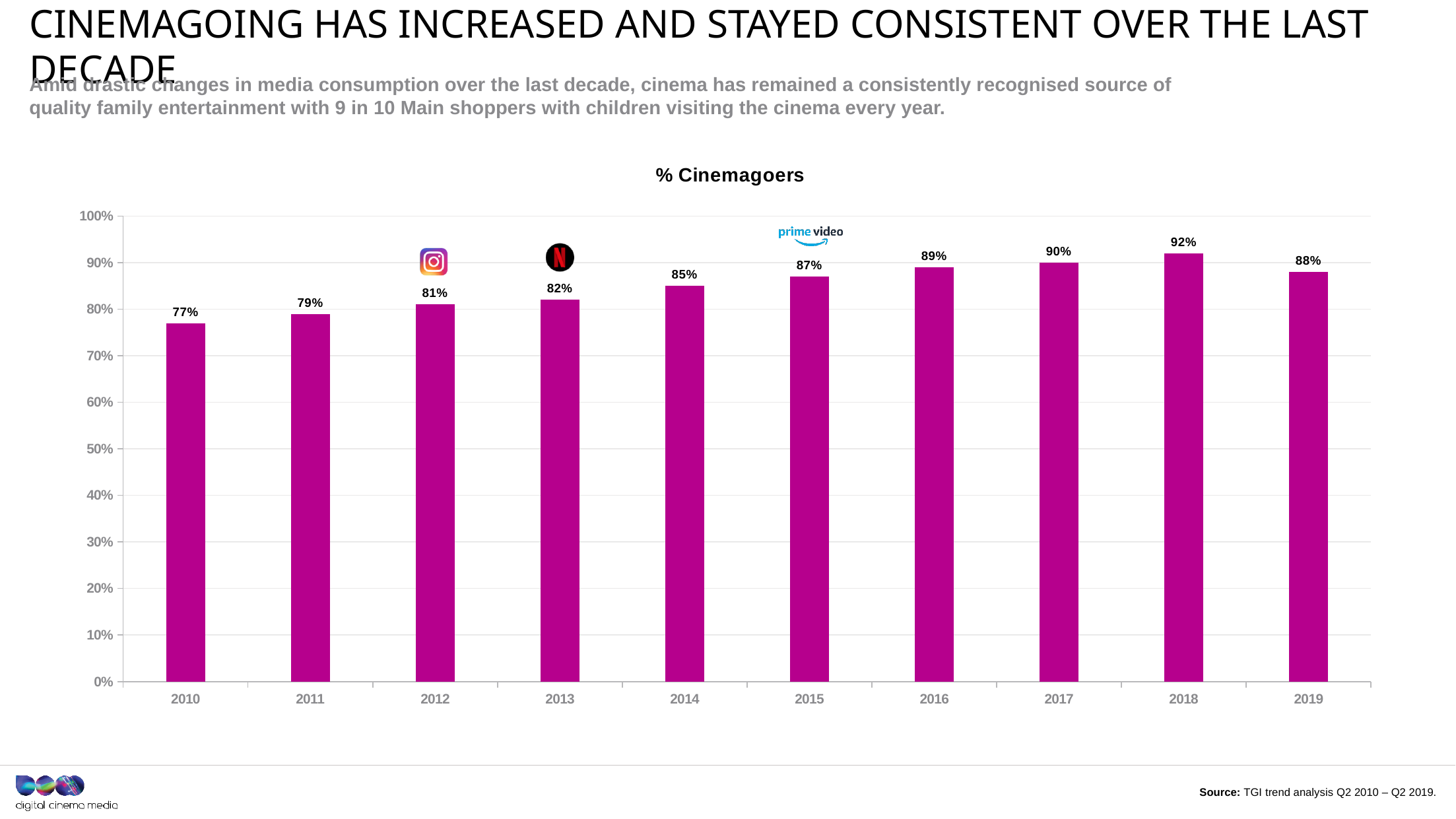
How many years are shown on the x axis? 10 What kind of chart is shown on the slide? bar chart What is the difference between the values for 2018 and 2010? 15% What is the value for 2015? 87% What is the value for 2019? 88% What is the title of the chart? % Cinemagoers Which year has the highest percentage of cinemagoers? 2018 Which year has the lowest percentage of cinemagoers? 2010 What is the difference between the values for 2019 and 2018? 4% Which is larger, the value for 2014 or the value for 2016? 2016 Is the value for 2013 greater or less than 90%? less What is the value for 2010? 77%